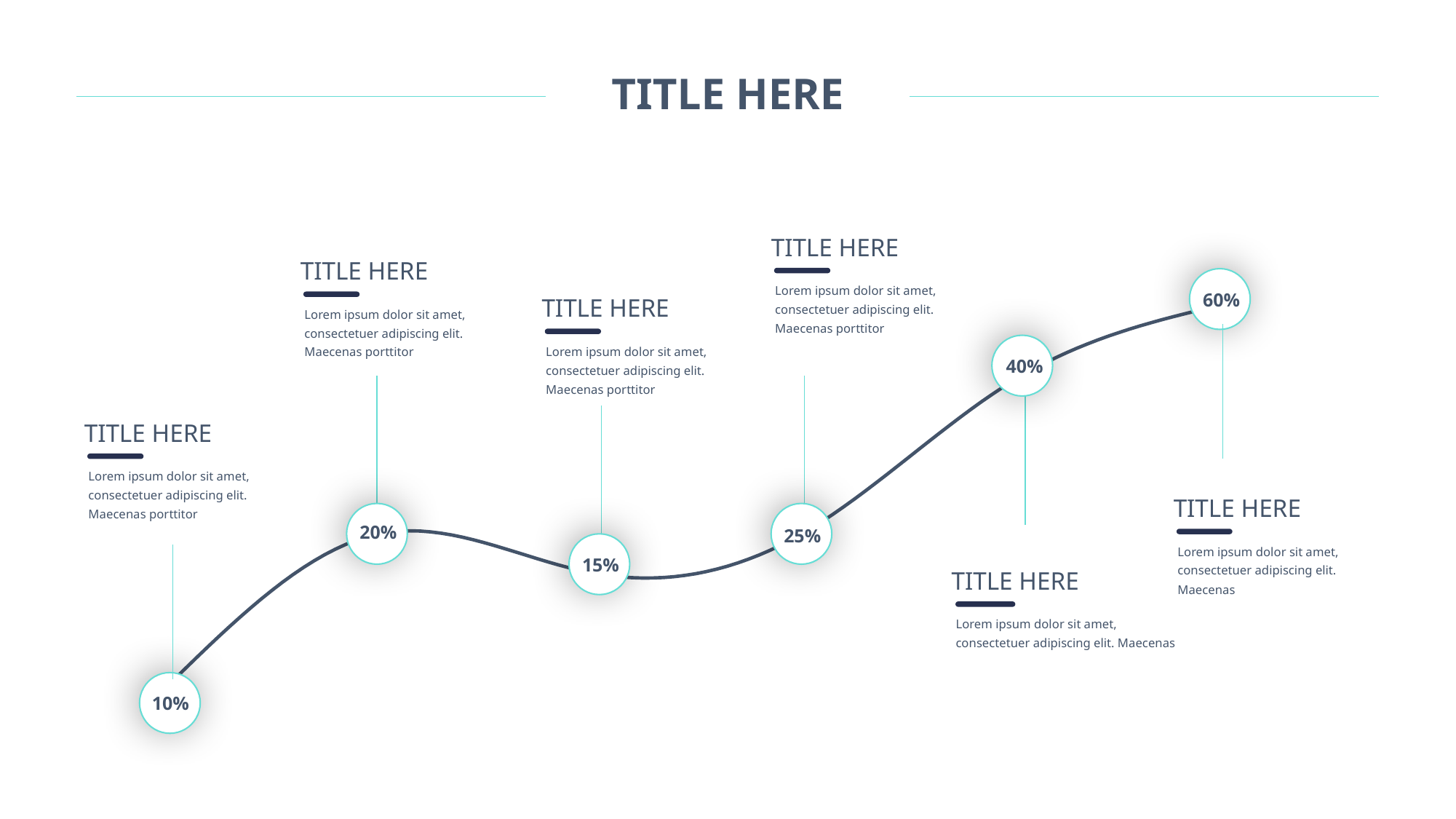
How many data points are plotted on the line? 6 What is the value of the fourth point from the left on the line? 25% What is the difference between the rightmost point (60%) and the fifth point (40%)? 20% What is the highest value plotted on the line? 60% What is the value of the first (leftmost) point on the line? 10% What is the value of the second point from the left on the line? 20% What is the value of the third point from the left on the line? 15% Overall, do the values rise or fall from left to right along the line? rise What is the lowest value plotted on the line? 10% What kind of chart is shown on the slide? line chart Which is larger, the second point from the left or the third point from the left? the second point (20%) What is the value of the last (rightmost) point on the line? 60%